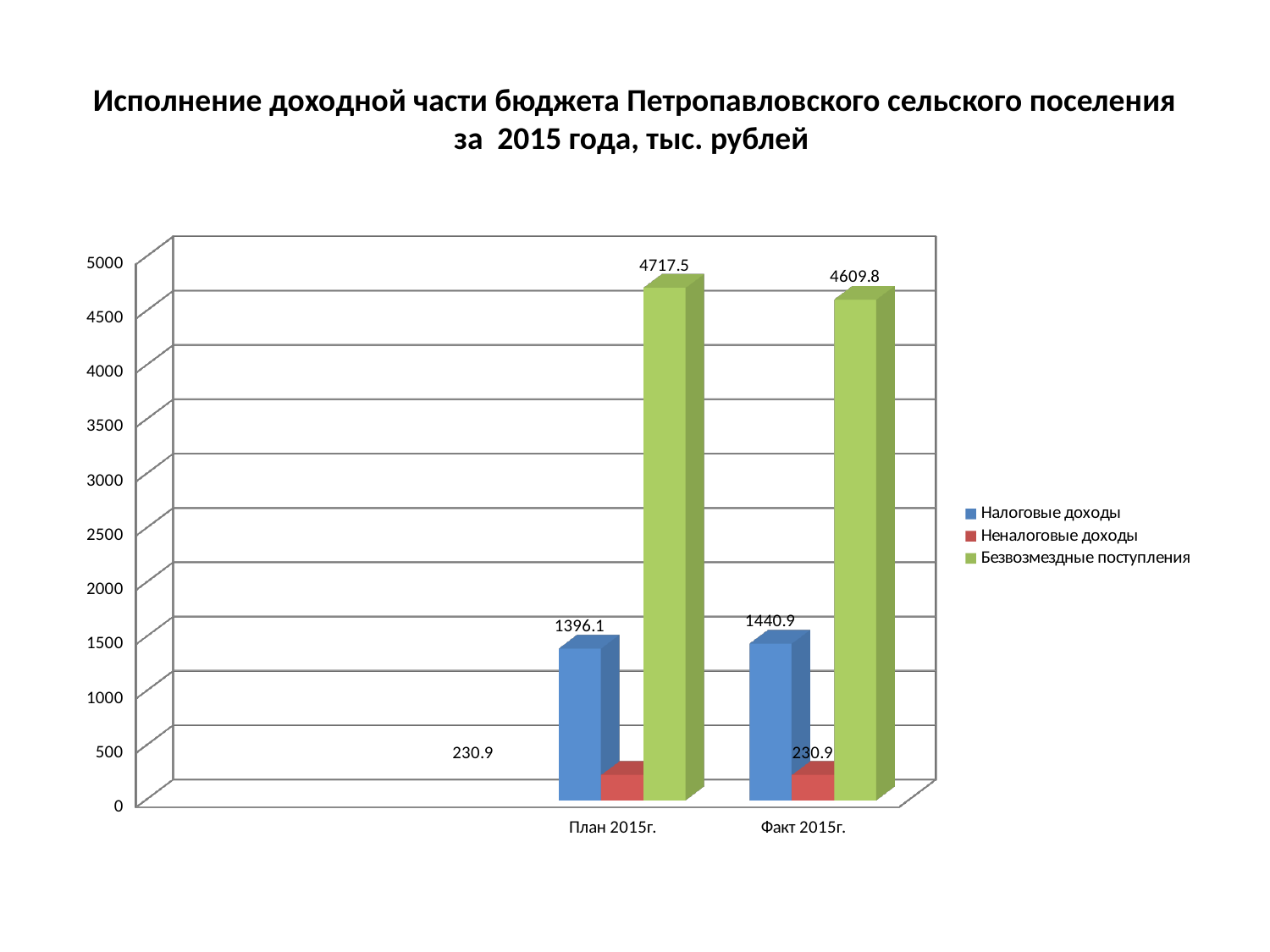
What is the value of Неналоговые доходы for Факт 2015г.? 230.9 Which series has the highest value for Факт 2015г.? Безвозмездные поступления Which is larger: Налоговые доходы for План 2015г. or for Факт 2015г.? Факт 2015г. How many series does the legend list? 3 Which series has the lowest value for План 2015г.? Неналоговые доходы What is the value of Безвозмездные поступления for Факт 2015г.? 4609.8 What is the value of Безвозмездные поступления for План 2015г.? 4717.5 What is the value of Налоговые доходы for Факт 2015г.? 1440.9 How many categories are shown on the x axis? 2 What is the value of Налоговые доходы for План 2015г.? 1396.1 What is the difference between Безвозмездные поступления for План 2015г. and Факт 2015г.? 107.7 What kind of chart is shown on the slide? Bar chart